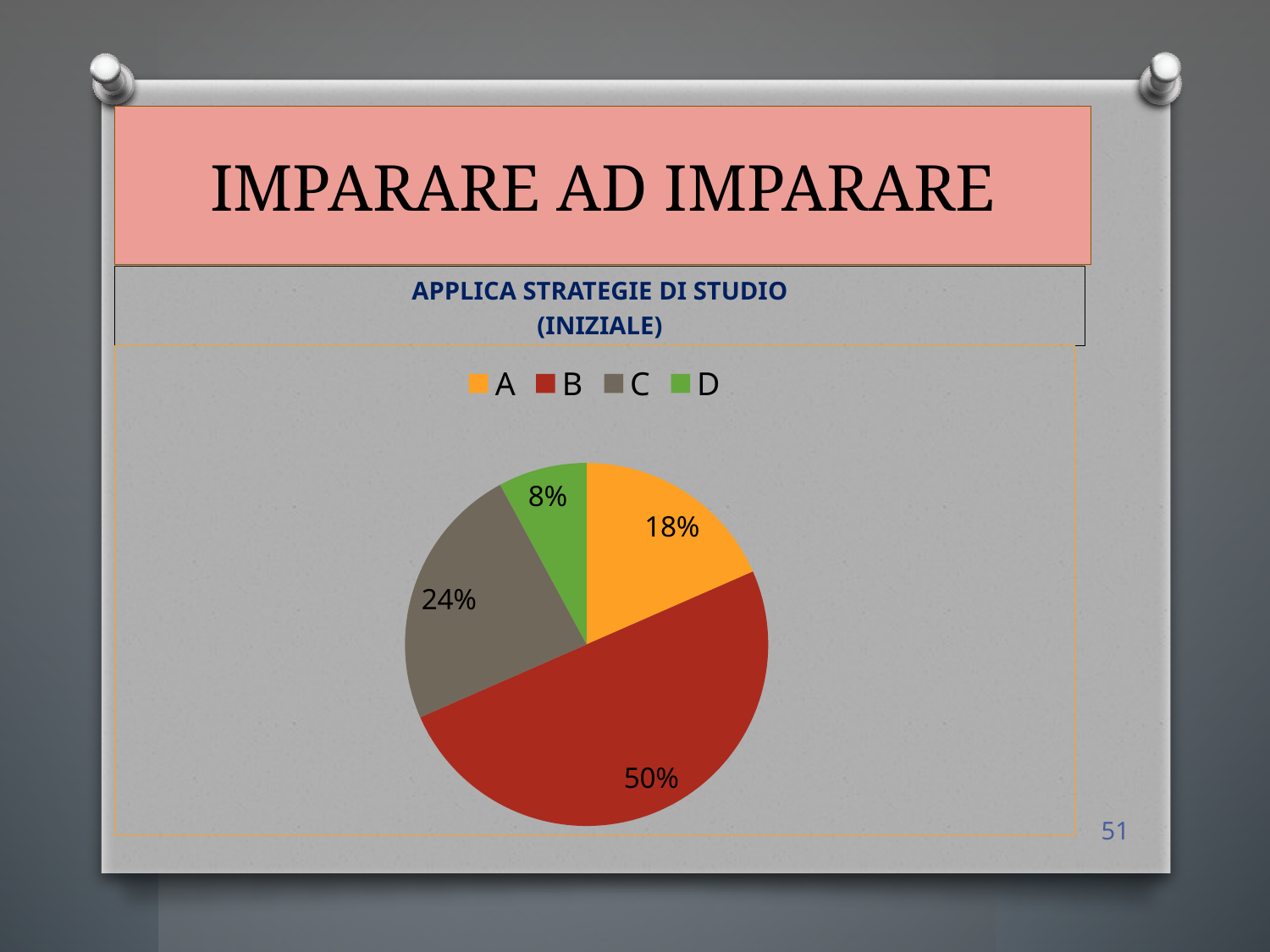
Which category has the smallest slice? D What colour is the slice for category B? red What share of the pie does category A have? 18% What share of the pie does category D have? 8% What is the difference between the shares of B and C? 26% What is the title of the chart? APPLICA STRATEGIE DI STUDIO (INIZIALE) What share of the pie does category B have? 50% Which is larger, the share of A or the share of C? C How many categories does the legend list? 4 What kind of chart is shown on the slide? pie chart What share of the pie does category C have? 24% Which category has the largest slice? B